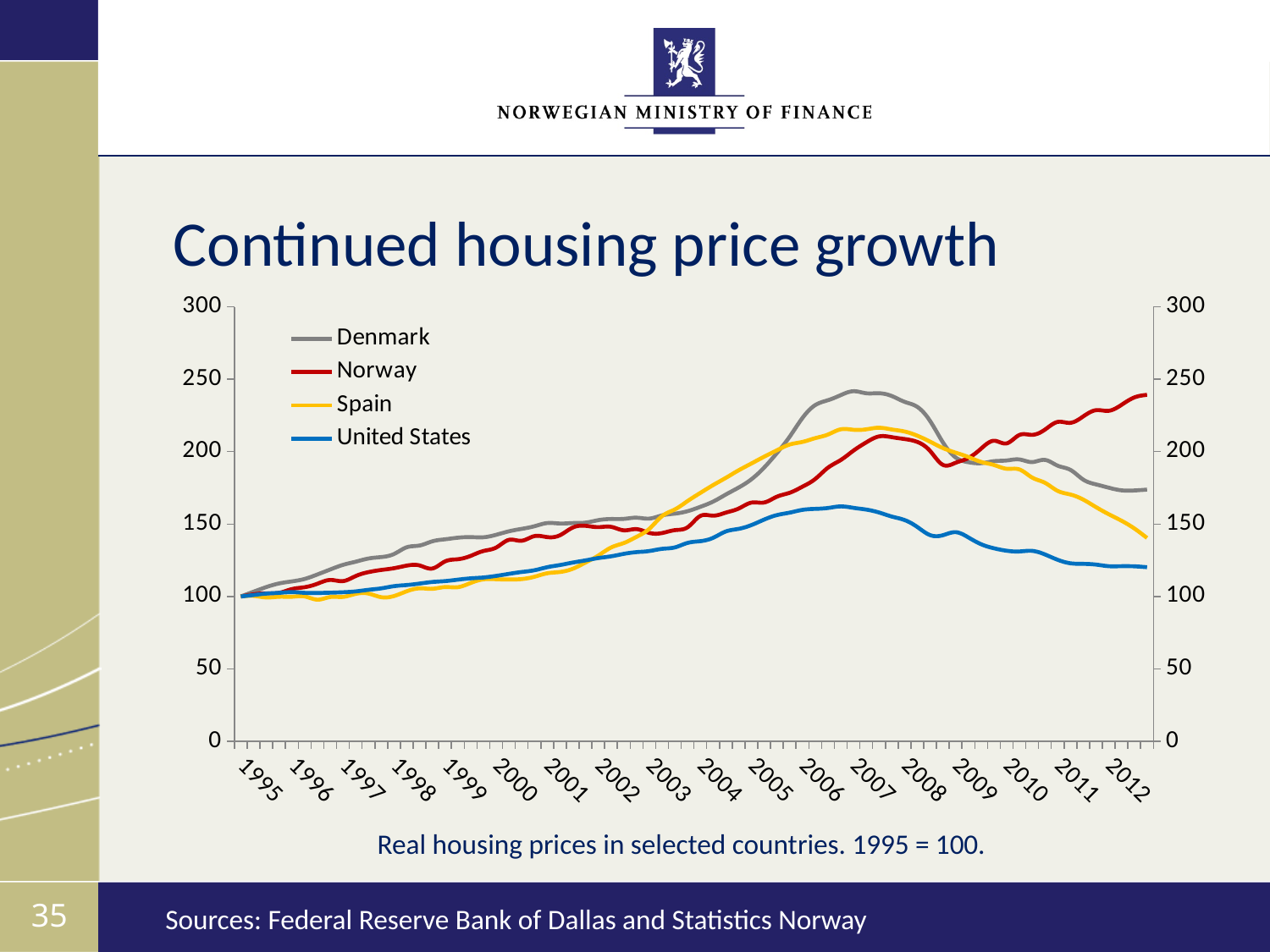
Which series has the highest value at the end of the chart in 2012? Norway Is the value for United States at the end of 2012 greater or less than 150? less Is the value for Norway at the end of 2012 greater or less than 200? greater Around 2007, which is larger: the value for Denmark or the value for United States? Denmark Does the United States series rise or fall between 2007 and 2012? fall What is the index value of all series in 1995? 100 Which series has the lowest value at the end of the chart in 2012? United States Is the peak value for Denmark around 2007 greater or less than 200? greater What kind of chart is shown on the slide? line chart Which countries are listed in the chart legend? Denmark, Norway, Spain, United States Does the Norway series rise or fall between 2009 and 2012? rise How many series does the legend list? 4